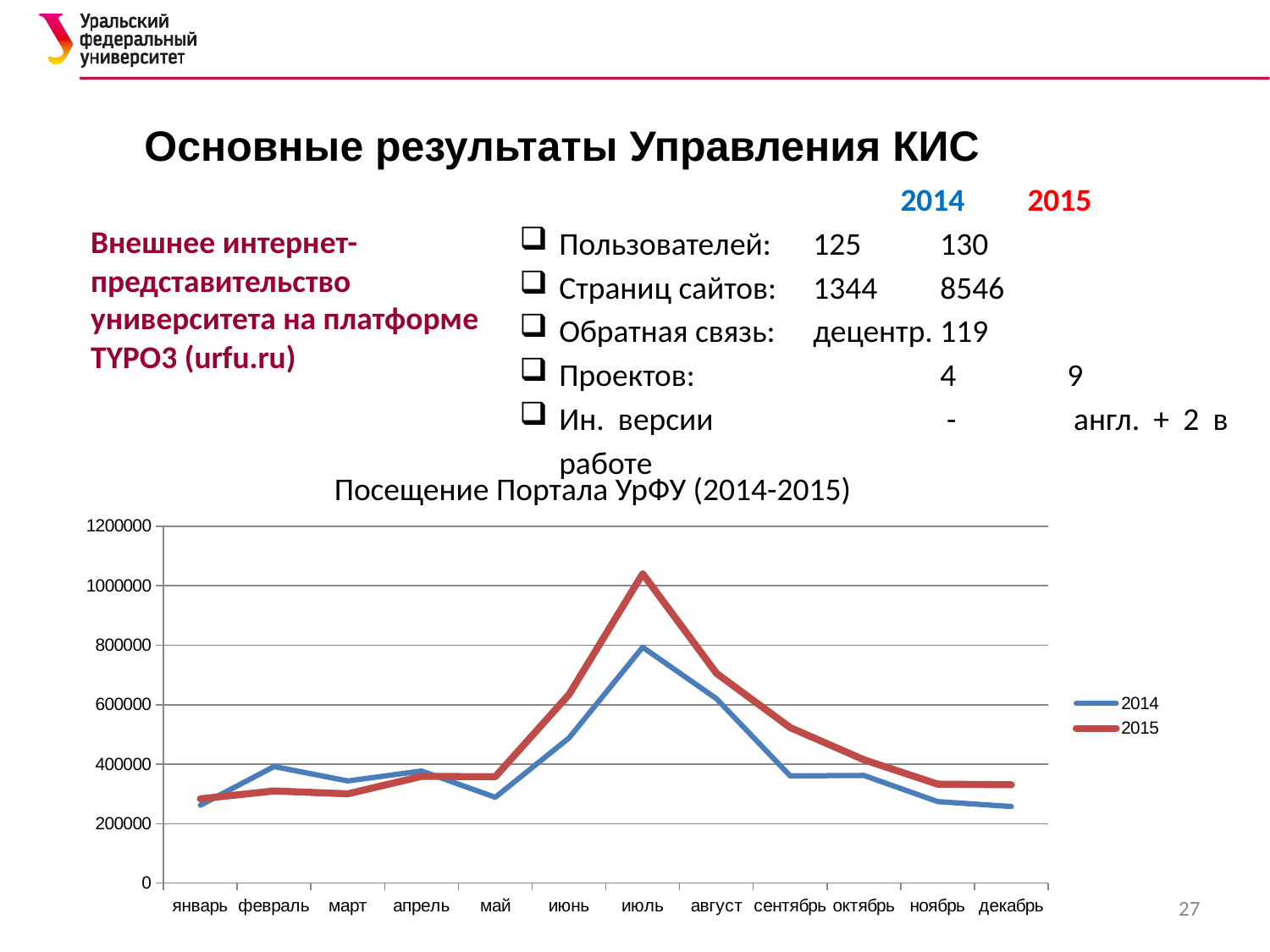
Is the value for 2015 in июль greater or less than 1000000? greater How many series does the chart legend list? 2 Which series has the larger value in февраль, 2014 or 2015? 2014 Is the value for 2014 in июль greater or less than 600000? greater In which month does the 2014 series reach its highest value? июль What kind of chart is shown on the slide? line chart What is the title of the chart? Посещение Портала УрФУ (2014-2015) Is the value for 2014 in январь greater or less than 400000? less How many months are plotted along the x axis of the chart? 12 Which series has the larger value in июль, 2014 or 2015? 2015 In which month does the 2015 series reach its highest value? июль